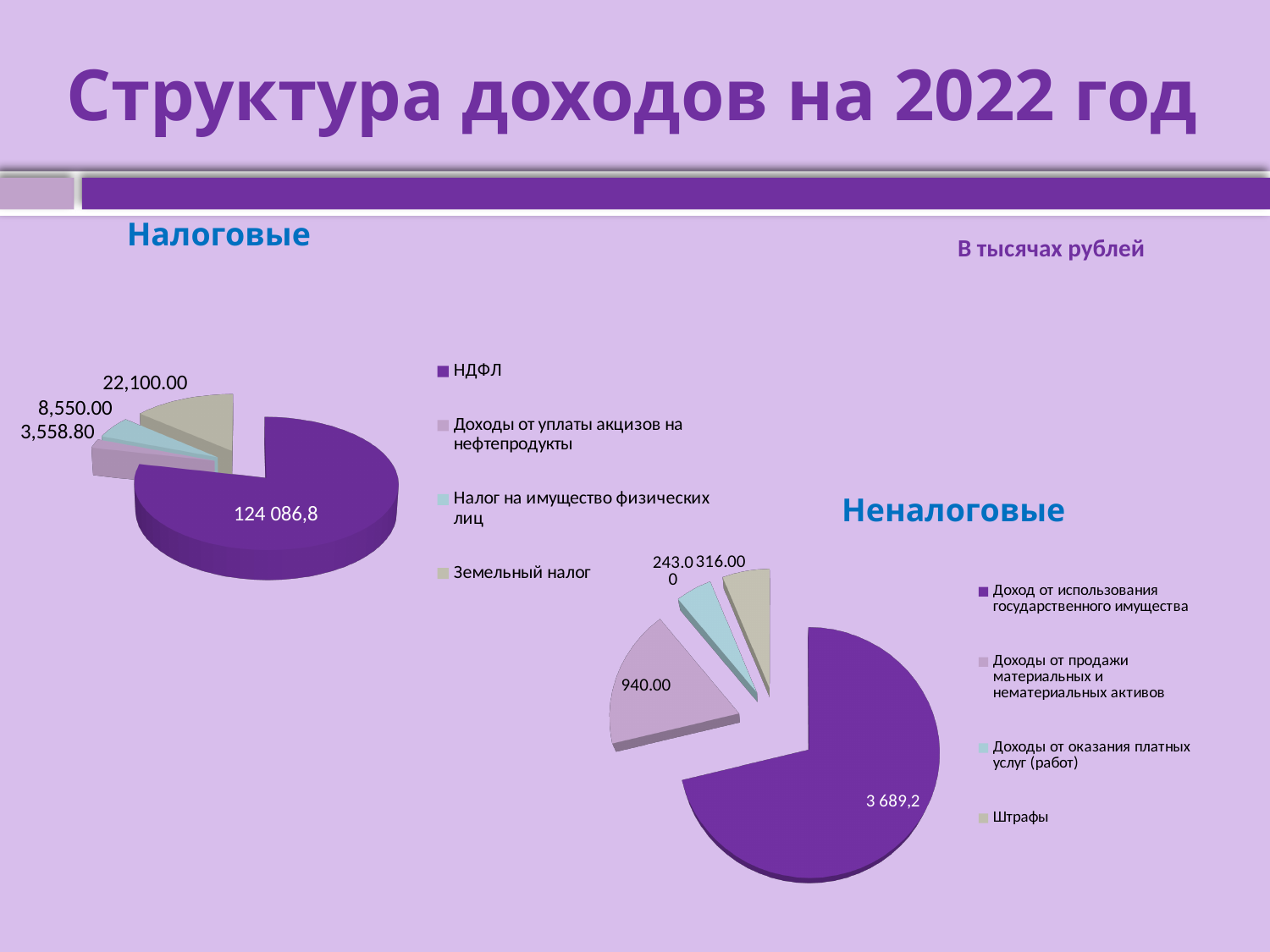
In the "Неналоговые" pie chart, what is the difference between the slice labelled 940.00 and the slice labelled 316.00? 624.00 In the "Налоговые" pie chart, which category has the largest slice? НДФЛ How many entries does the legend of the "Неналоговые" pie chart list? 4 What type of chart is used for the "Налоговые" data? pie chart In the "Налоговые" pie chart, what is the difference between the slice labelled 22,100.00 and the slice labelled 8,550.00? 13,550.00 In the "Налоговые" pie chart, which is larger: the slice labelled 8,550.00 or the slice labelled 3,558.80? 8,550.00 In the "Налоговые" pie chart, what is the value for НДФЛ? 124 086,8 In the "Неналоговые" pie chart, what is the value for Доход от использования государственного имущества? 3 689,2 In the "Неналоговые" pie chart, what is the value for Штрафы? 316.00 In what units are the values on the slide expressed, according to the note at the top right? В тысячах рублей How many slices does the "Налоговые" pie chart have? 4 In the "Неналоговые" pie chart, which category has the smallest slice? Доходы от оказания платных услуг (работ)